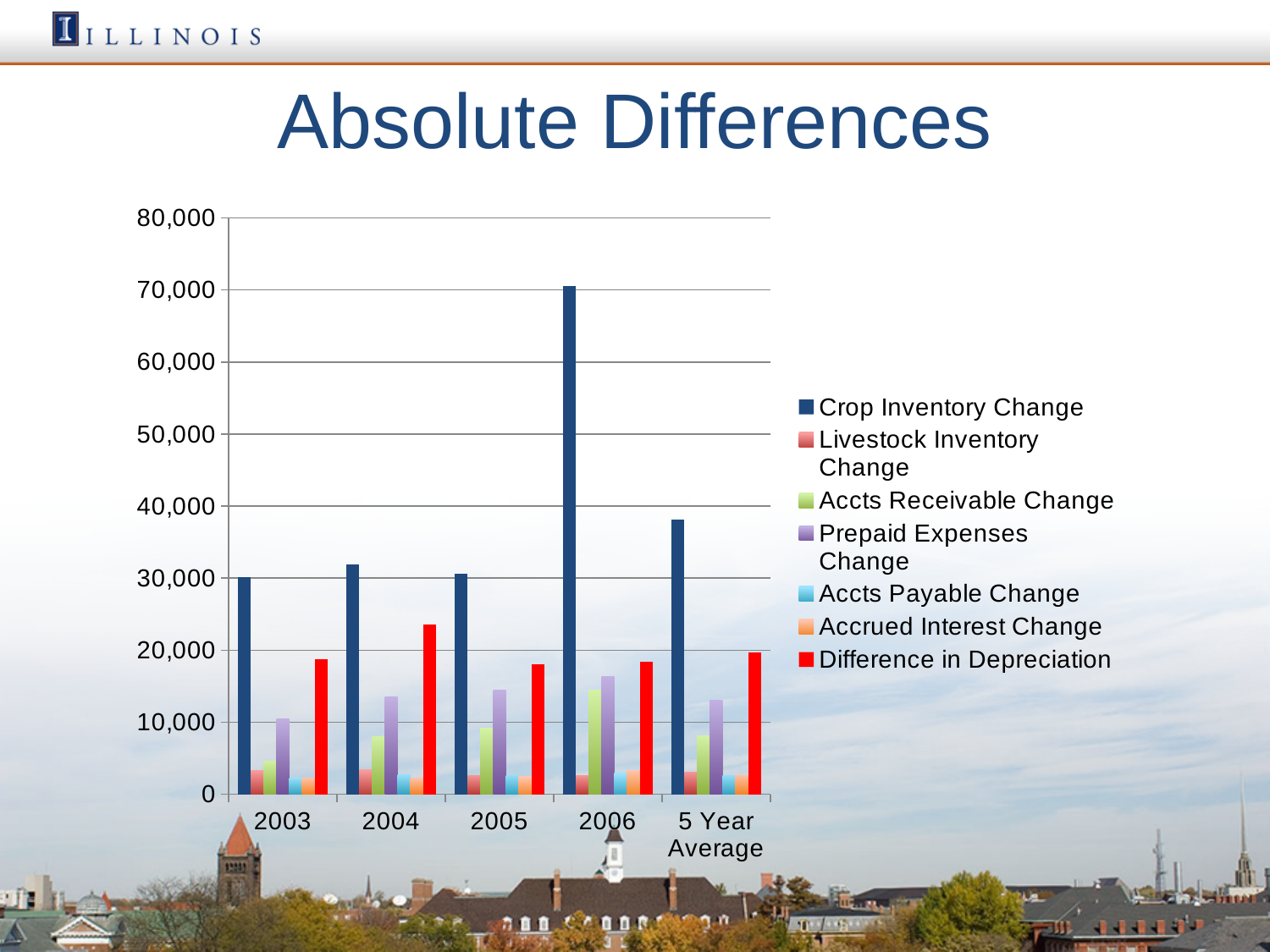
In which year is Crop Inventory Change the highest? 2006 Which is larger in 2006: Crop Inventory Change or Difference in Depreciation? Crop Inventory Change How many series does the legend list? 7 Is the Crop Inventory Change value for 5 Year Average greater or less than 30,000? greater How many categories are shown along the x axis? 5 In which category is Difference in Depreciation the highest? 2004 Is the Prepaid Expenses Change value for 2006 greater or less than 10,000? greater What is the title of the chart? Absolute Differences Which colour represents Difference in Depreciation in the legend? red Is the Difference in Depreciation value for 2004 greater or less than 20,000? greater What kind of chart is shown on the slide? bar chart